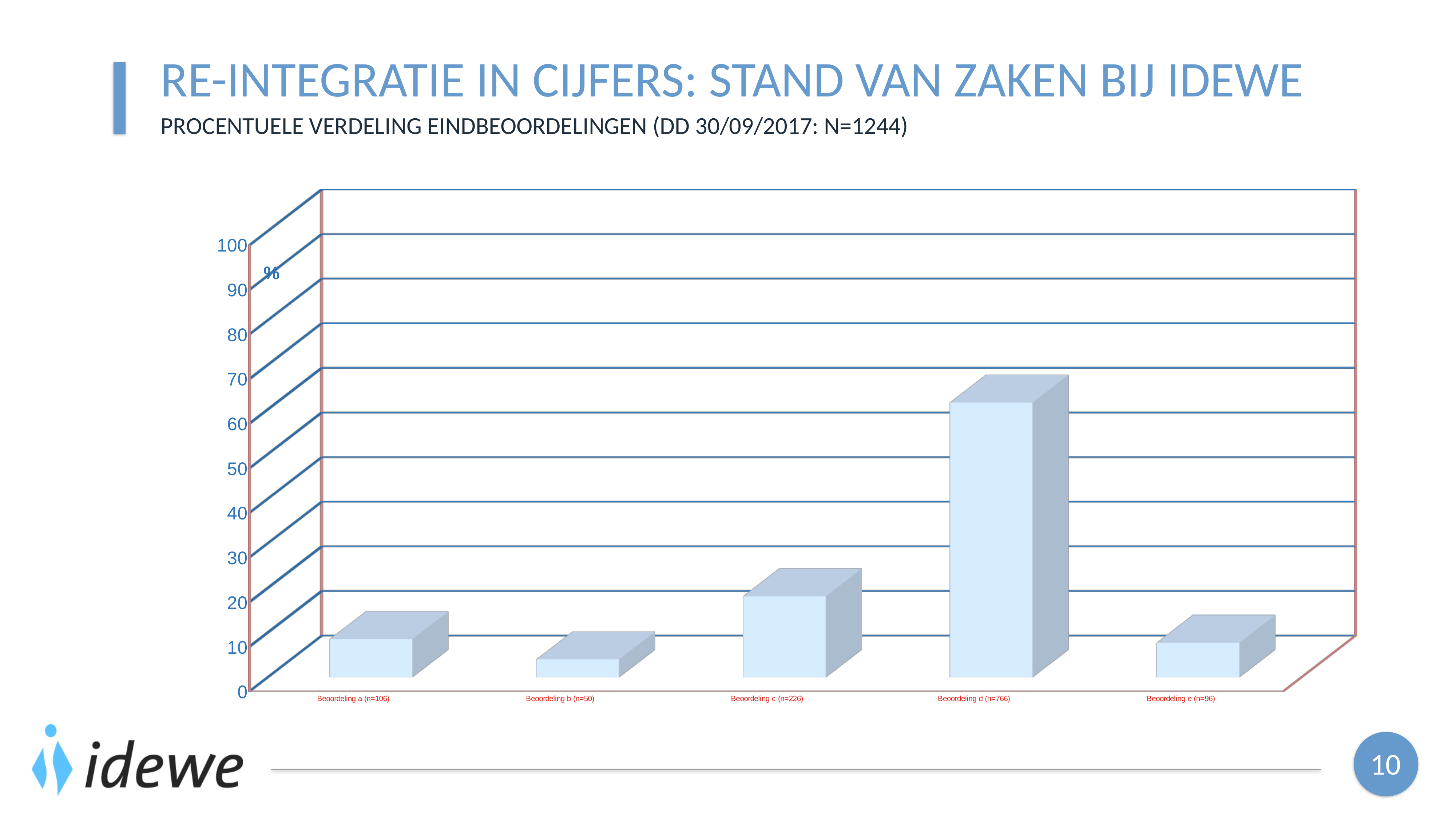
Which category has the highest bar in the chart? Beoordeling d (n=766) Is the value for Beoordeling a (n=106) greater or less than 20? less Which category has the lowest bar in the chart? Beoordeling b (n=50) Is the value for Beoordeling d (n=766) greater or less than 50? greater How many categories (Beoordeling bars) are shown in the chart? 5 Is the value for Beoordeling c (n=226) greater or less than 30? less What unit is shown on the vertical axis of the chart? % What kind of chart is shown on the slide? bar chart According to the chart subtitle, what is the total N of the final assessments? N=1244 Which is larger, the value for Beoordeling d (n=766) or Beoordeling c (n=226)? Beoordeling d (n=766) Which is larger, the value for Beoordeling c (n=226) or Beoordeling a (n=106)? Beoordeling c (n=226)